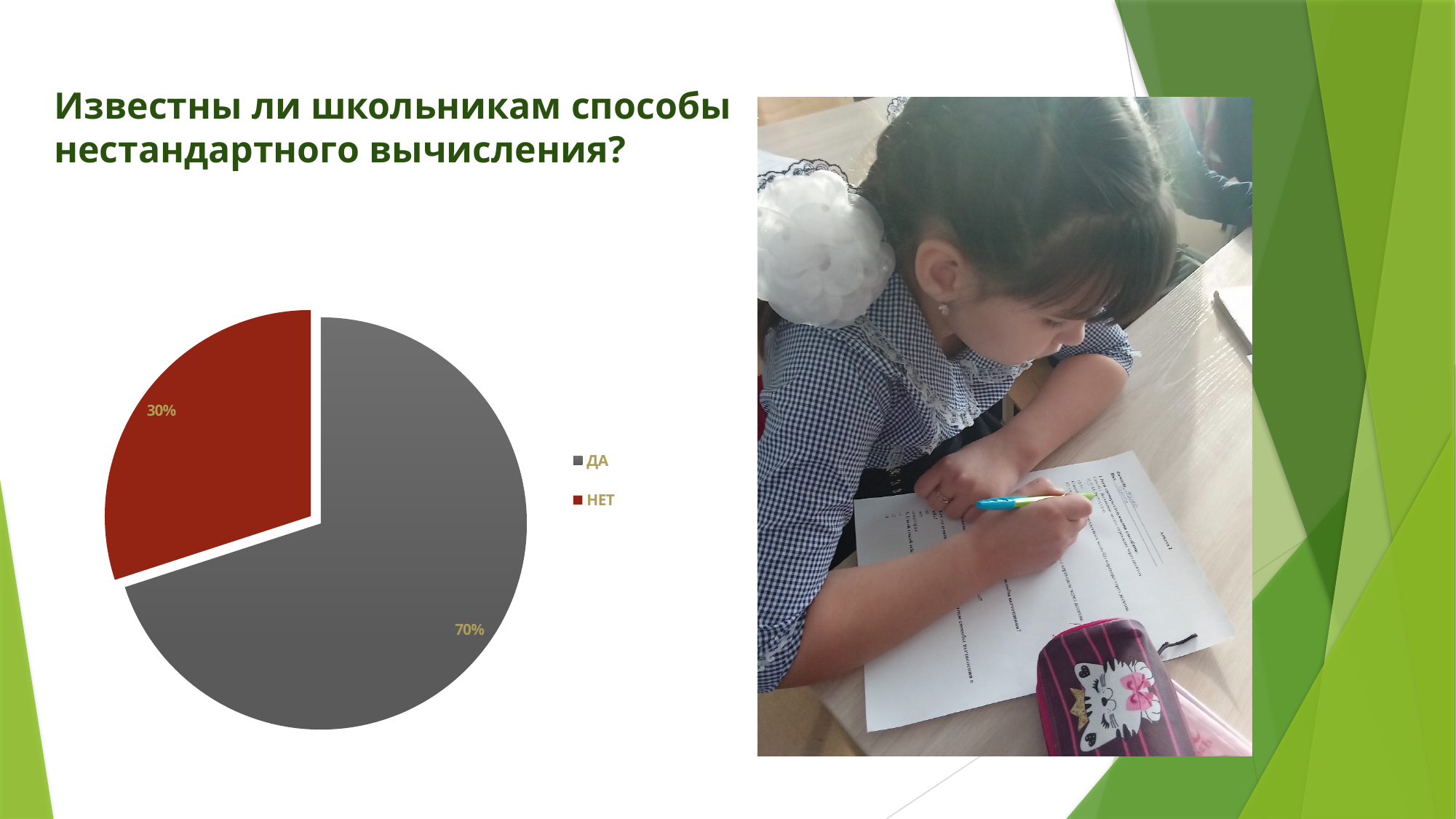
What is the difference in percentage points between the ДА and НЕТ slices? 40% What kind of chart is shown on the slide? pie chart How many entries does the legend list? 2 Which is larger, the ДА slice or the НЕТ slice? ДА What share of the pie does ДА represent? 70% How many categories does the pie chart have? 2 Which category has the smallest slice of the pie? НЕТ What colour is the НЕТ slice? red Which category has the largest slice of the pie? ДА What colour is the ДА slice? grey What share of the pie does НЕТ represent? 30%